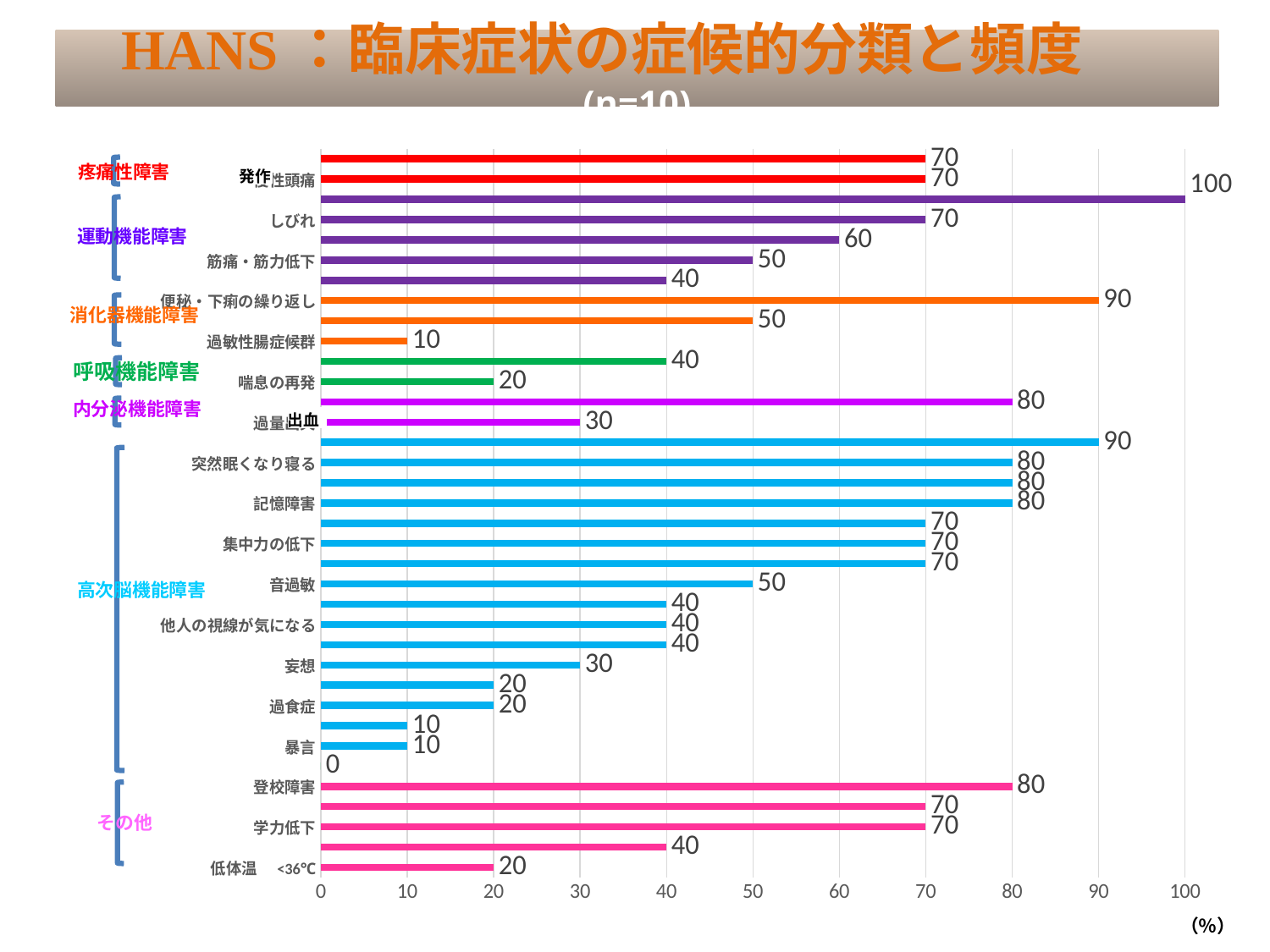
What is the value for 便秘・下痢の繰り返し? 90 What is the highest value shown on the chart? 100 What is the value for 過敏性腸症候群? 10 What is the value for 喘息の再発? 20 What is the value for 低体温 <36℃? 20 What is the value for 突然眠くなり寝る? 80 Which has a larger value, 登校障害 or 学力低下? 登校障害 What is the lowest value shown on the chart? 0 What unit is shown at the end of the x axis? (%) What is the difference between the values for 便秘・下痢の繰り返し and 過敏性腸症候群? 80 Is the value for 記憶障害 greater or less than 50? greater What kind of chart is shown on the slide? bar chart